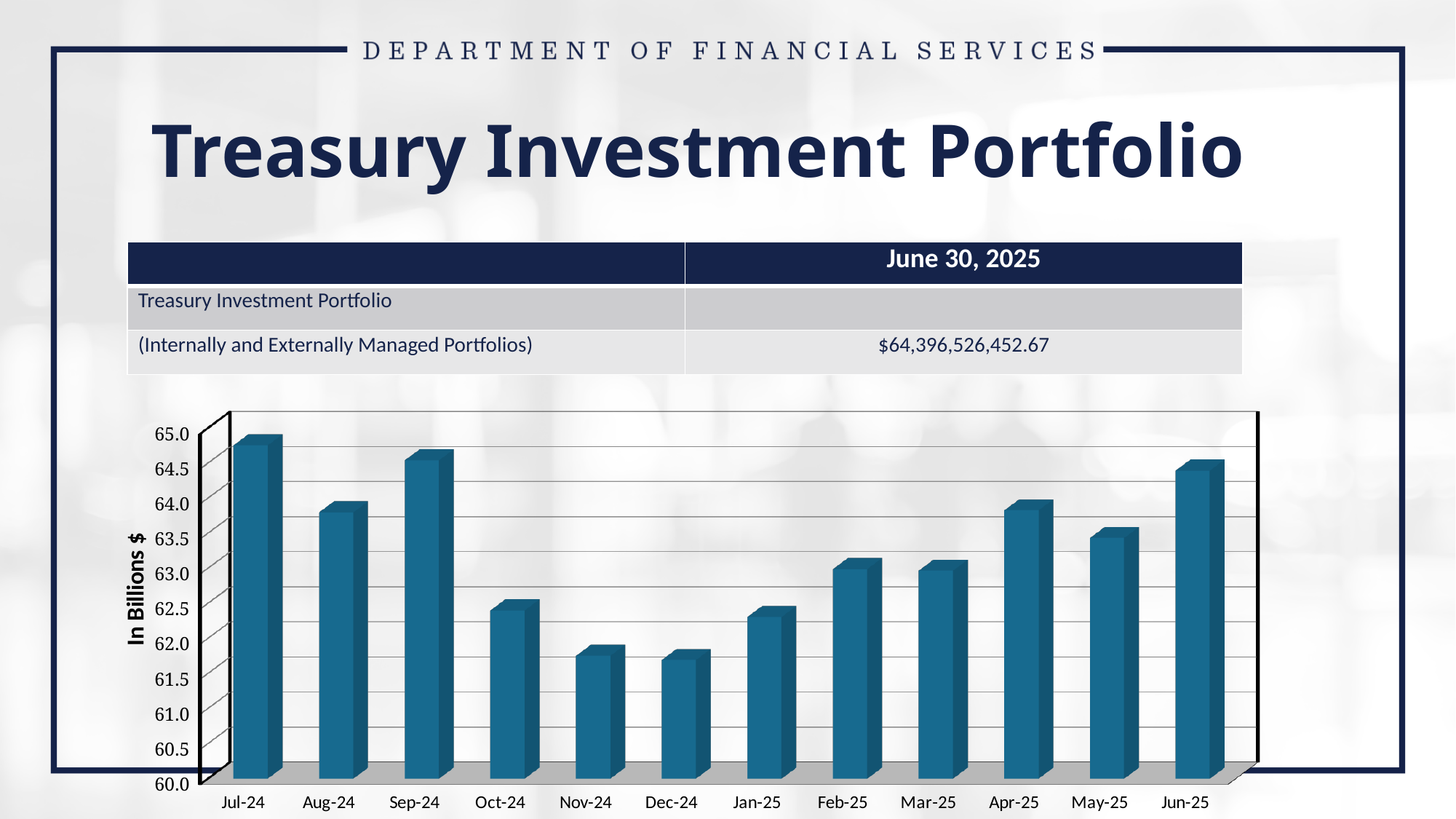
Is the value for May-25 greater or less than 63.0? greater Do the values rise or fall from Dec-24 to Jun-25? rise Is the value for Oct-24 greater or less than 63.0? less What kind of chart is shown on the slide? bar chart Is the value for Jun-25 greater or less than 64.0? greater What is the label on the vertical axis of the chart? In Billions $ Which month has the highest value on the chart? Jul-24 How many months are plotted on the chart? 12 Which is larger, the value for Apr-25 or the value for Jan-25? Apr-25 Which is larger, the value for Sep-24 or the value for Oct-24? Sep-24